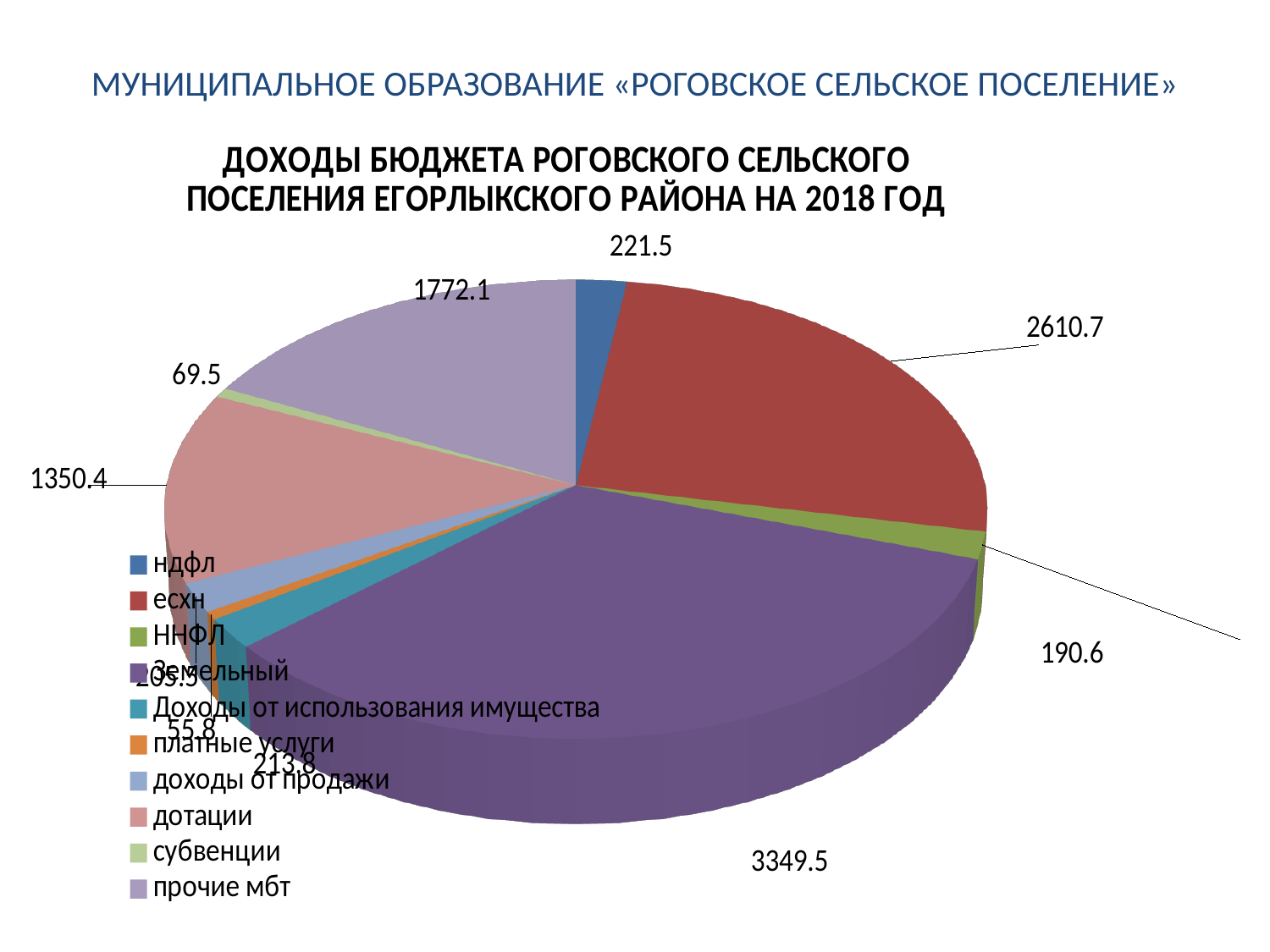
Which category has the largest slice of the pie? земельный Which is larger, есхн or прочие мбт? есхн What is the title of the chart? ДОХОДЫ БЮДЖЕТА РОГОВСКОГО СЕЛЬСКОГО ПОСЕЛЕНИЯ ЕГОРЛЫКСКОГО РАЙОНА НА 2018 ГОД What is the value for ндфл? 221.5 What is the value for земельный? 3349.5 What is the value for дотации? 1350.4 What is the value for есхн? 2610.7 What type of chart is shown on the slide? pie chart What is the value for прочие мбт? 1772.1 How many categories does the legend list? 10 What is the difference between the values for земельный and есхн? 738.8 What is the value for субвенции? 69.5